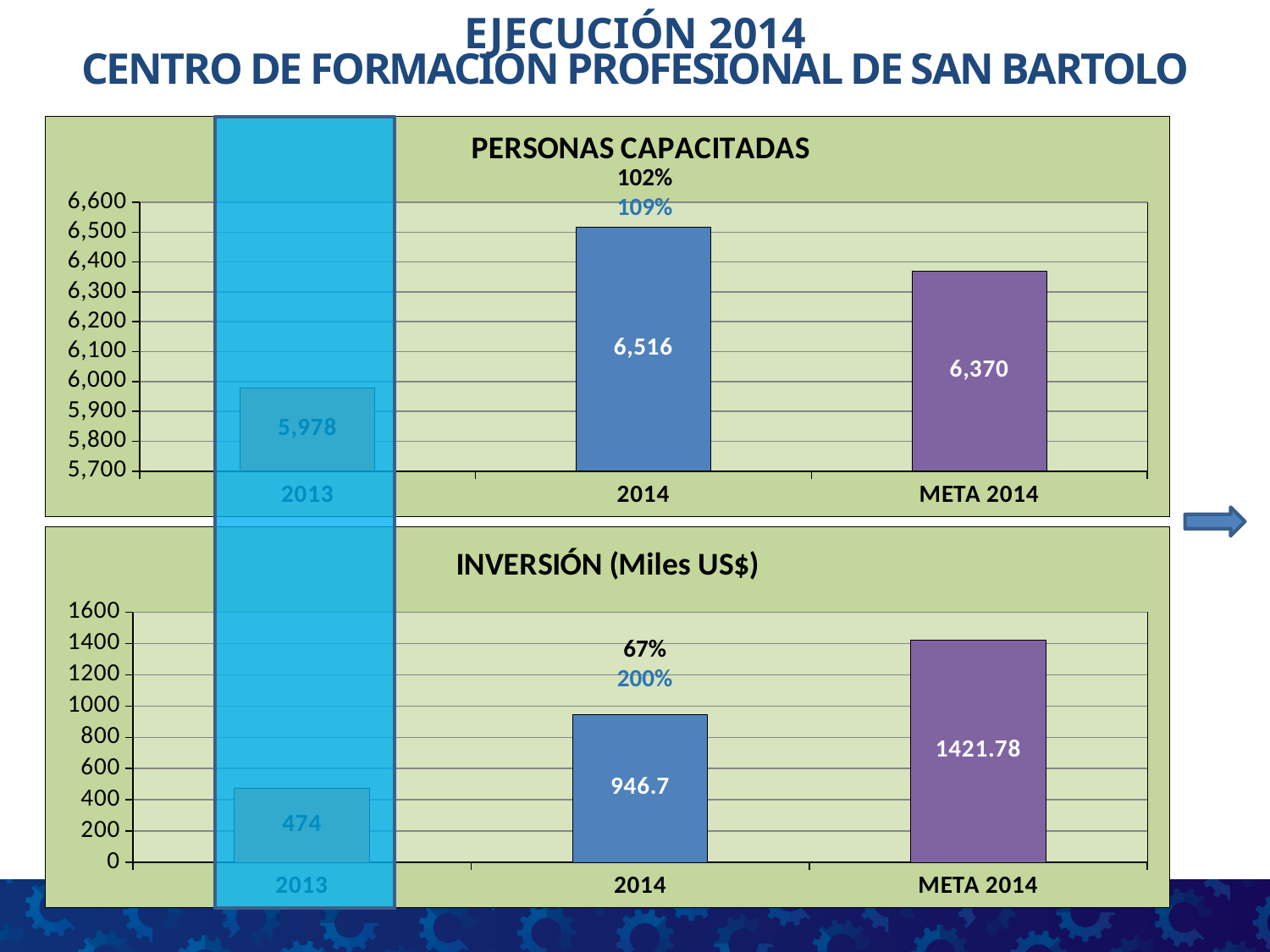
In the INVERSIÓN (Miles US$) chart, is the value for 2014 larger or smaller than the value for META 2014? smaller How many categories are shown in the PERSONAS CAPACITADAS chart? 3 In the PERSONAS CAPACITADAS chart, which category has the highest value? 2014 In the INVERSIÓN (Miles US$) chart, what is the value for 2014? 946.7 What kind of chart is the INVERSIÓN (Miles US$) chart? bar chart In the PERSONAS CAPACITADAS chart, what is the difference between the 2014 value and the META 2014 value? 146 In the PERSONAS CAPACITADAS chart, what is the value for 2014? 6,516 In the INVERSIÓN (Miles US$) chart, what is the value for META 2014? 1421.78 In the INVERSIÓN (Miles US$) chart, which category has the lowest value? 2013 In the PERSONAS CAPACITADAS chart, what is the value for META 2014? 6,370 In the INVERSIÓN (Miles US$) chart, what is the value for 2013? 474 In the PERSONAS CAPACITADAS chart, what is the value for 2013? 5,978